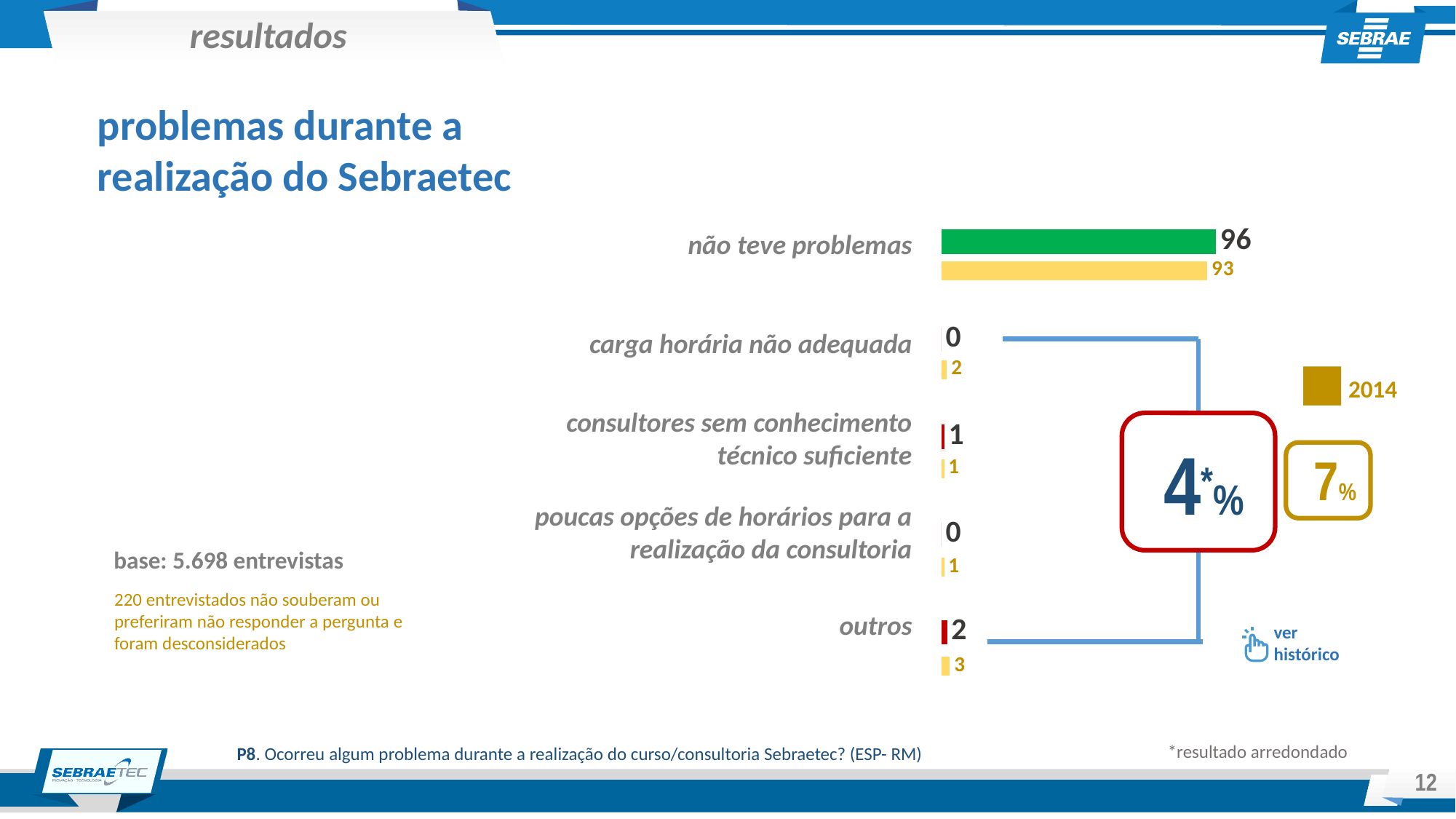
What is the 2014 (yellow) value for 'carga horária não adequada'? 2 What is the 2014 (yellow) value for 'outros'? 3 What kind of chart is shown on the slide? bar chart What is the value of the top (non-2014) bar for 'consultores sem conhecimento técnico suficiente'? 1 What is the difference between the top bar (96) and the 2014 bar (93) for 'não teve problemas'? 3 For 'carga horária não adequada', which is larger: the top bar value or the 2014 value? 2014 How many categories are shown in the chart? 5 What is the 2014 (yellow) value for 'não teve problemas'? 93 What is the value of the top (non-2014) bar for 'outros'? 2 What is the value of the green bar for 'não teve problemas'? 96 Which category has the highest value in the chart? não teve problemas Which year does the yellow bar series represent according to the legend? 2014